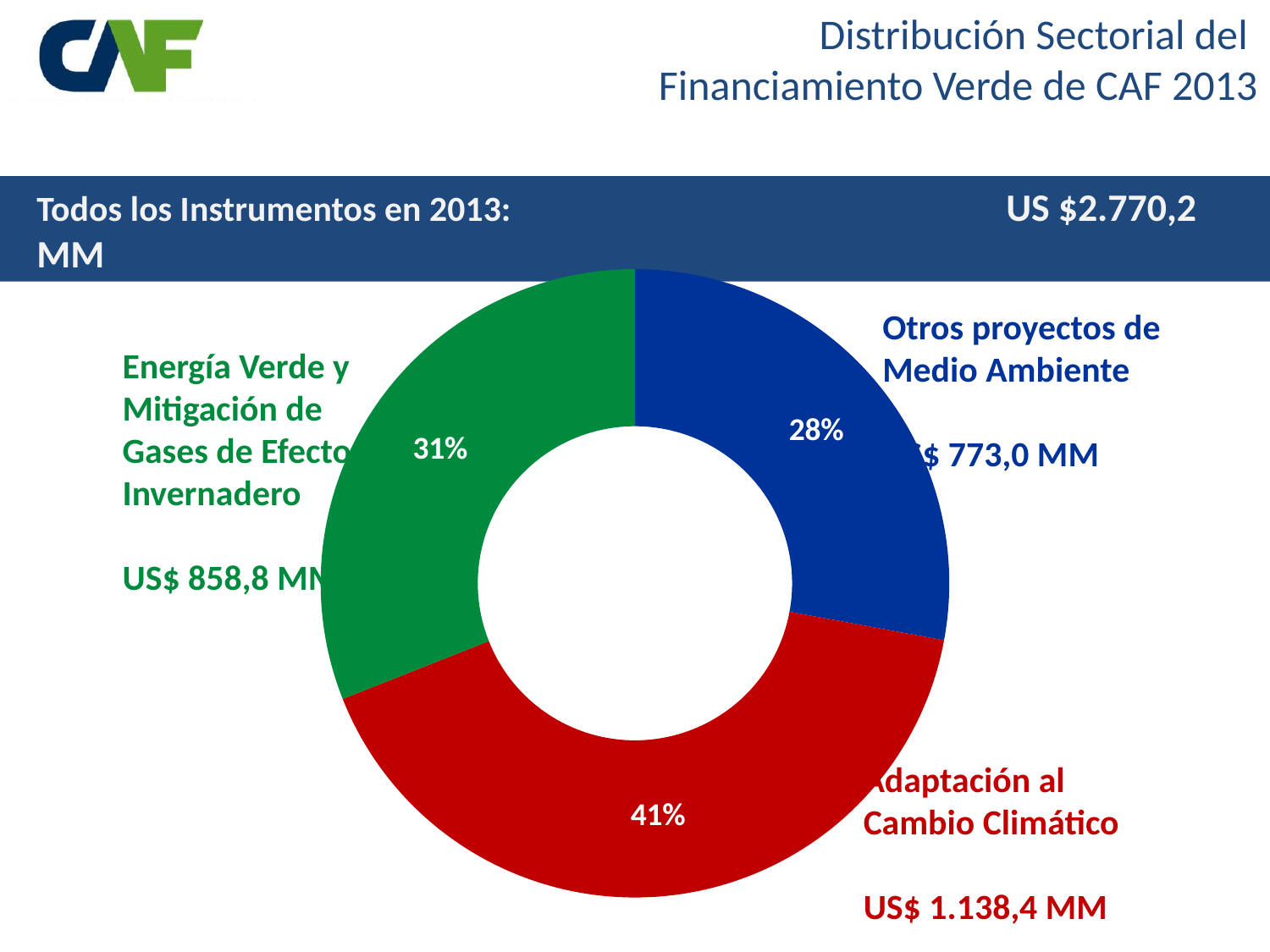
What amount in US$ MM is shown for Adaptación al Cambio Climático? US$ 1.138,4 MM Which sector has the largest share of the chart? Adaptación al Cambio Climático Which sector has the smallest share of the chart? Otros proyectos de Medio Ambiente Which share is larger: Energía Verde y Mitigación de Gases de Efecto Invernadero or Otros proyectos de Medio Ambiente? Energía Verde y Mitigación de Gases de Efecto Invernadero How many sectors are shown in the chart? 3 What share of the pie does Energía Verde y Mitigación de Gases de Efecto Invernadero represent? 31% What share of the pie does Otros proyectos de Medio Ambiente represent? 28% What kind of chart is shown on the slide? Pie (donut) chart What amount in US$ MM is shown for Energía Verde y Mitigación de Gases de Efecto Invernadero? US$ 858,8 MM What is the difference in percentage points between the Adaptación al Cambio Climático share and the Energía Verde y Mitigación share? 10 percentage points What colour is the slice for Adaptación al Cambio Climático? Red What share of the pie does Adaptación al Cambio Climático represent? 41%